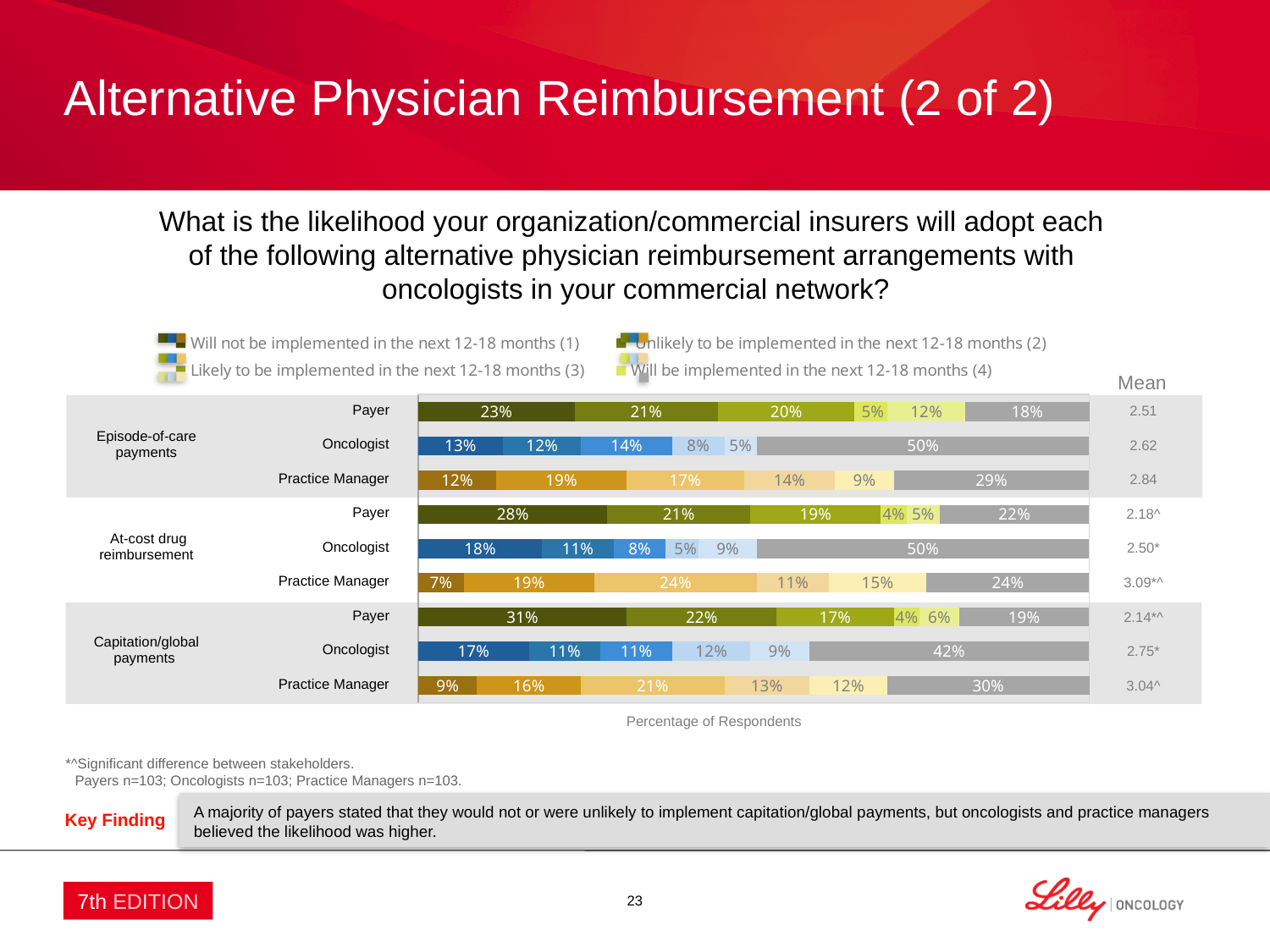
What is the axis label shown beneath the bars? Percentage of Respondents What percentage is shown in the leftmost (darkest) segment of the Payer bar for Capitation/global payments? 31% What percentage is shown in the leftmost segment of the Practice Manager bar for At-cost drug reimbursement? 7% What is the mean value shown for Practice Manager under At-cost drug reimbursement? 3.09*^ What is the difference between the leftmost segment of the Payer bar for Capitation/global payments (31%) and the leftmost segment of the Payer bar for Episode-of-care payments (23%)? 8 percentage points How many bars are plotted on the chart? 9 Which stakeholder and arrangement has the lowest mean value on the chart? Payer, Capitation/global payments (2.14) What is the mean value shown for Payer under Episode-of-care payments? 2.51 Which stakeholder has the highest mean value for Capitation/global payments? Practice Manager For Practice Manager, which has the larger mean: At-cost drug reimbursement or Episode-of-care payments? At-cost drug reimbursement What percentage is shown in the rightmost (gray) segment of the Oncologist bar for Episode-of-care payments? 50% What kind of chart is shown on the slide? Stacked horizontal bar chart